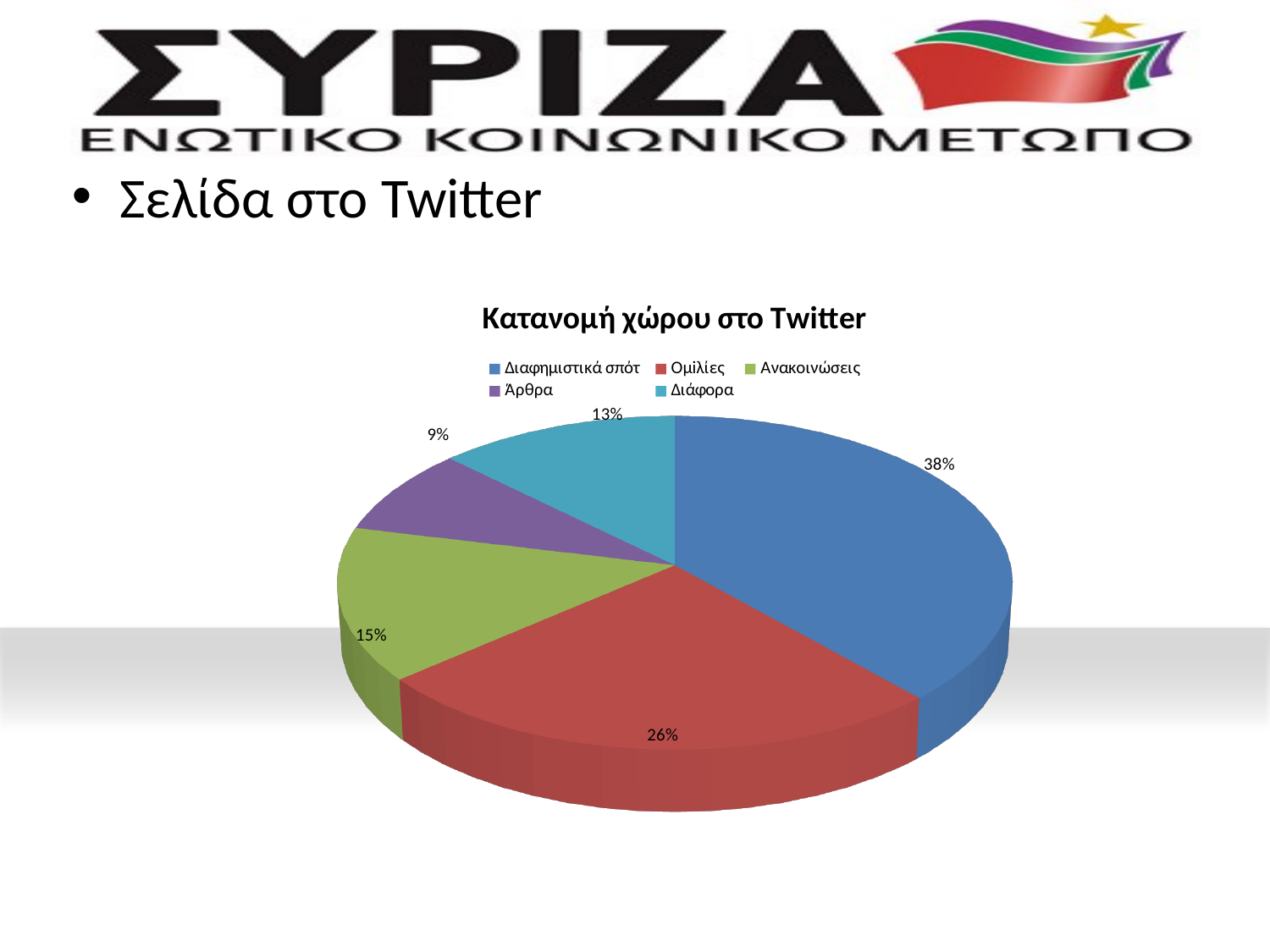
What share of the pie does Διαφημιστικά σπότ have? 38% What is the title of the chart? Κατανομή χώρου στο Twitter Which category has the largest share of the pie? Διαφημιστικά σπότ How many categories does the legend list? 5 Which has a larger share, Ανακοινώσεις or Διάφορα? Ανακοινώσεις Which category has the smallest share of the pie? Άρθρα What share of the pie does Διάφορα have? 13% What share of the pie does Άρθρα have? 9% What kind of chart is shown on the slide? pie chart What is the difference between the shares of Διαφημιστικά σπότ and Ομιλίες? 12%